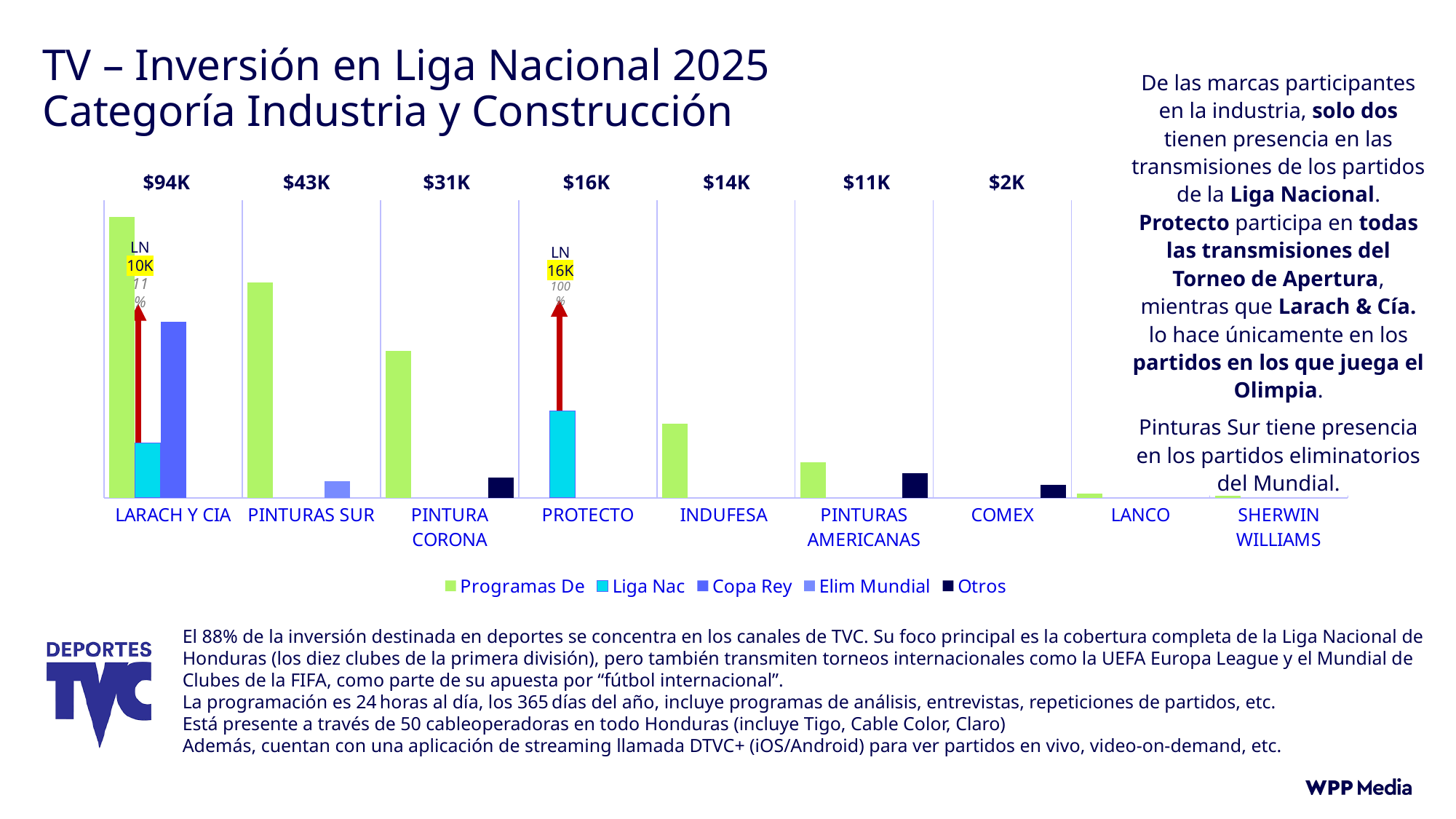
How many series does the chart legend list? 5 Which brand has the highest total investment in the chart? LARACH Y CIA What is the total investment shown above the bars for LARACH Y CIA? $94K What Liga Nac (LN) value is annotated for LARACH Y CIA? 10K How many brands (categories) are shown on the x axis of the chart? 9 What is the difference between the total investment of LARACH Y CIA and PINTURAS SUR? $51K What kind of chart is shown on the slide? Bar chart What is the total investment shown above the bars for PINTURAS SUR? $43K What Liga Nac (LN) value is annotated for PROTECTO? 16K What is the total investment shown above the bars for COMEX? $2K Which has a larger total investment, INDUFESA or PINTURAS AMERICANAS? INDUFESA Do the total investment values rise or fall moving from left to right along the x axis? Fall